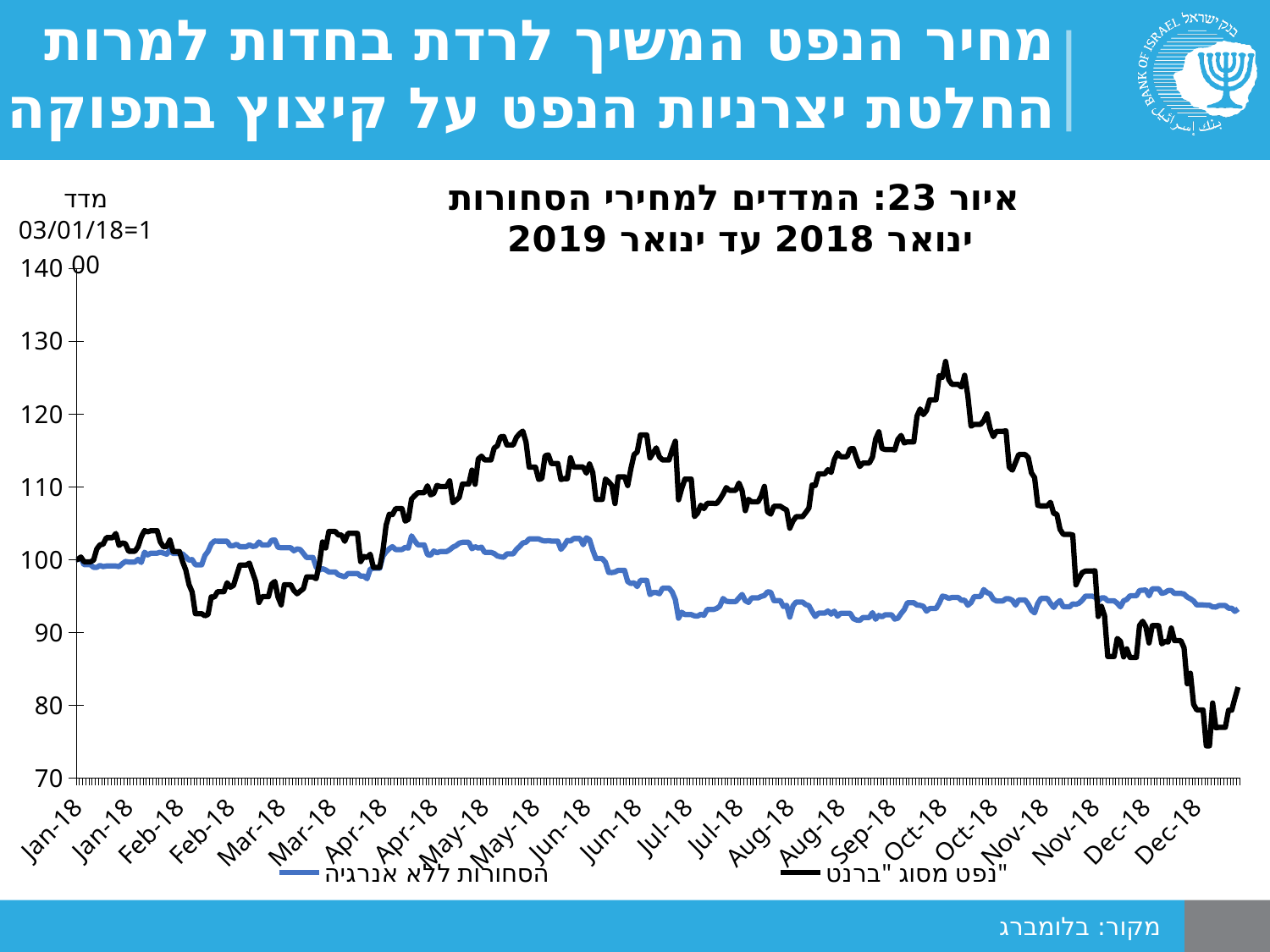
Is the value of the Brent oil (נפט מסוג "ברנט") series at the end of Dec-18 greater or less than 90? less How many series does the chart's legend list? 2 In Oct-18, which series has the higher value: Brent oil (נפט מסוג "ברנט") or non-energy commodities (הסחורות ללא אנרגיה)? נפט מסוג "ברנט" Is the value of the non-energy commodities (הסחורות ללא אנרגיה) series in Dec-18 greater or less than 100? less In Dec-18, which series has the higher value: Brent oil (נפט מסוג "ברנט") or non-energy commodities (הסחורות ללא אנרגיה)? הסחורות ללא אנרגיה Does the Brent oil (נפט מסוג "ברנט") series end the period (Dec-18) higher or lower than it started (Jan-18)? lower Is the peak value of the Brent oil (נפט מסוג "ברנט") series, reached around Oct-18, greater or less than 120? greater Which series is drawn in black on the chart? נפט מסוג "ברנט" Which series is drawn in blue on the chart? הסחורות ללא אנרגיה What kind of chart is shown on the slide? line chart Does the non-energy commodities (הסחורות ללא אנרגיה) series rise or fall between Jun-18 and Jul-18? fall